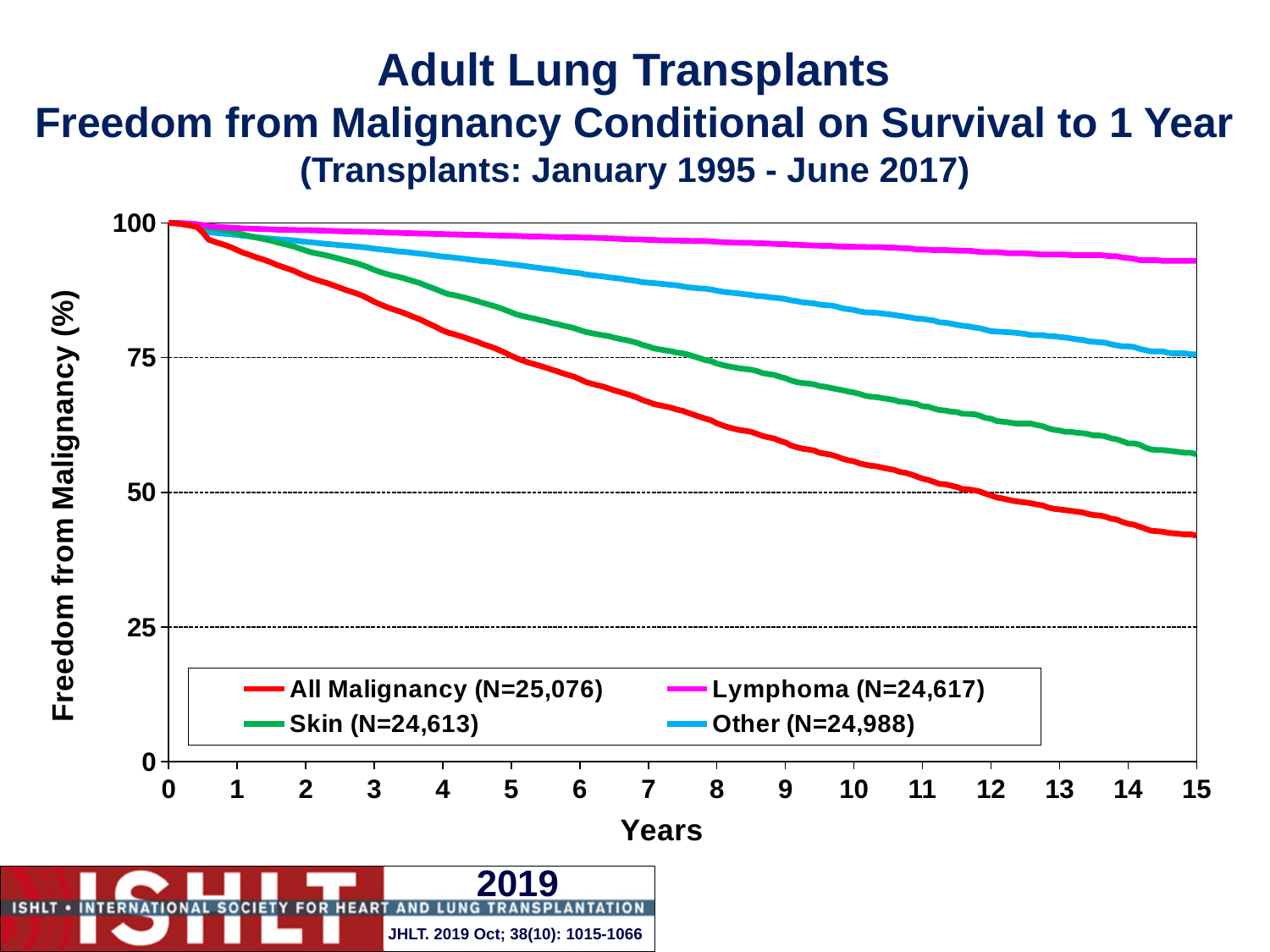
What is the freedom from malignancy value for all series at year 0? 100 Is the value for All Malignancy at 15 years greater or less than 50? less Which series has the lowest freedom from malignancy at 15 years? All Malignancy At 15 years, which series has the higher value: Skin or Other? Other Is the value for All Malignancy at 7 years greater or less than 75? less What is the N shown in the legend for All Malignancy? 25,076 What type of chart is shown on the slide? line chart Which series has the highest freedom from malignancy at 15 years? Lymphoma Is the value for Skin at 15 years greater or less than 50? greater How many series does the legend list? 4 Do the freedom from malignancy values rise or fall as years increase? fall